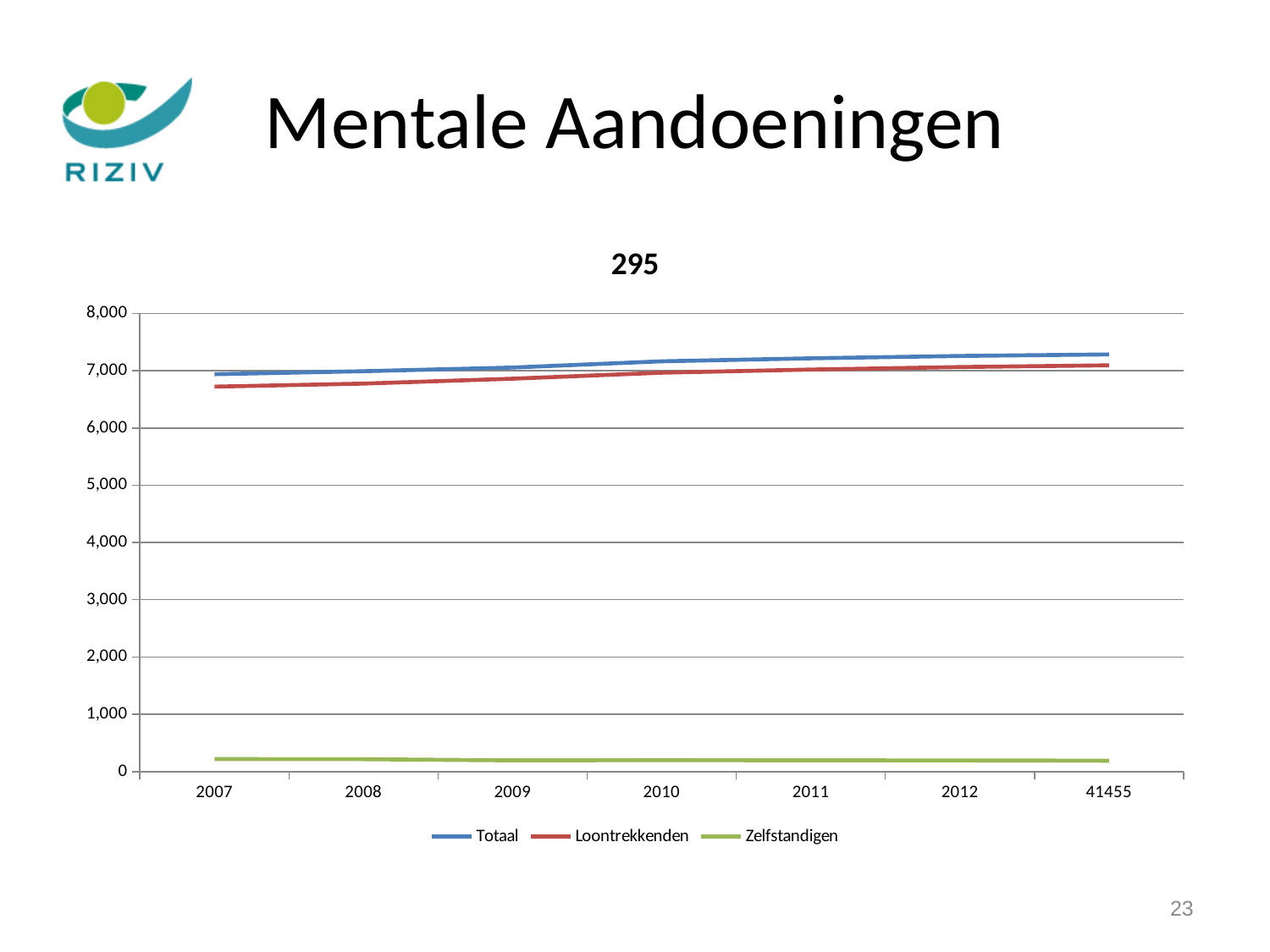
Is the value for Zelfstandigen in 2010 greater or less than 1,000? less Is the value for Loontrekkenden in 2007 greater or less than 7,000? less How many points are plotted along the x axis for each series? 7 Which series has the highest values across the chart? Totaal Is the value for Totaal in 2012 greater or less than 7,000? greater How many series does the legend list? 3 Does the Totaal series rise or fall from 2007 to the last point on the x axis? rise What kind of chart is shown on the slide? line chart Which series has the lowest values across the chart? Zelfstandigen Which series is drawn in green in the legend? Zelfstandigen What is the title of the chart? 295 Does the Loontrekkenden series rise or fall from 2007 to 2012? rise